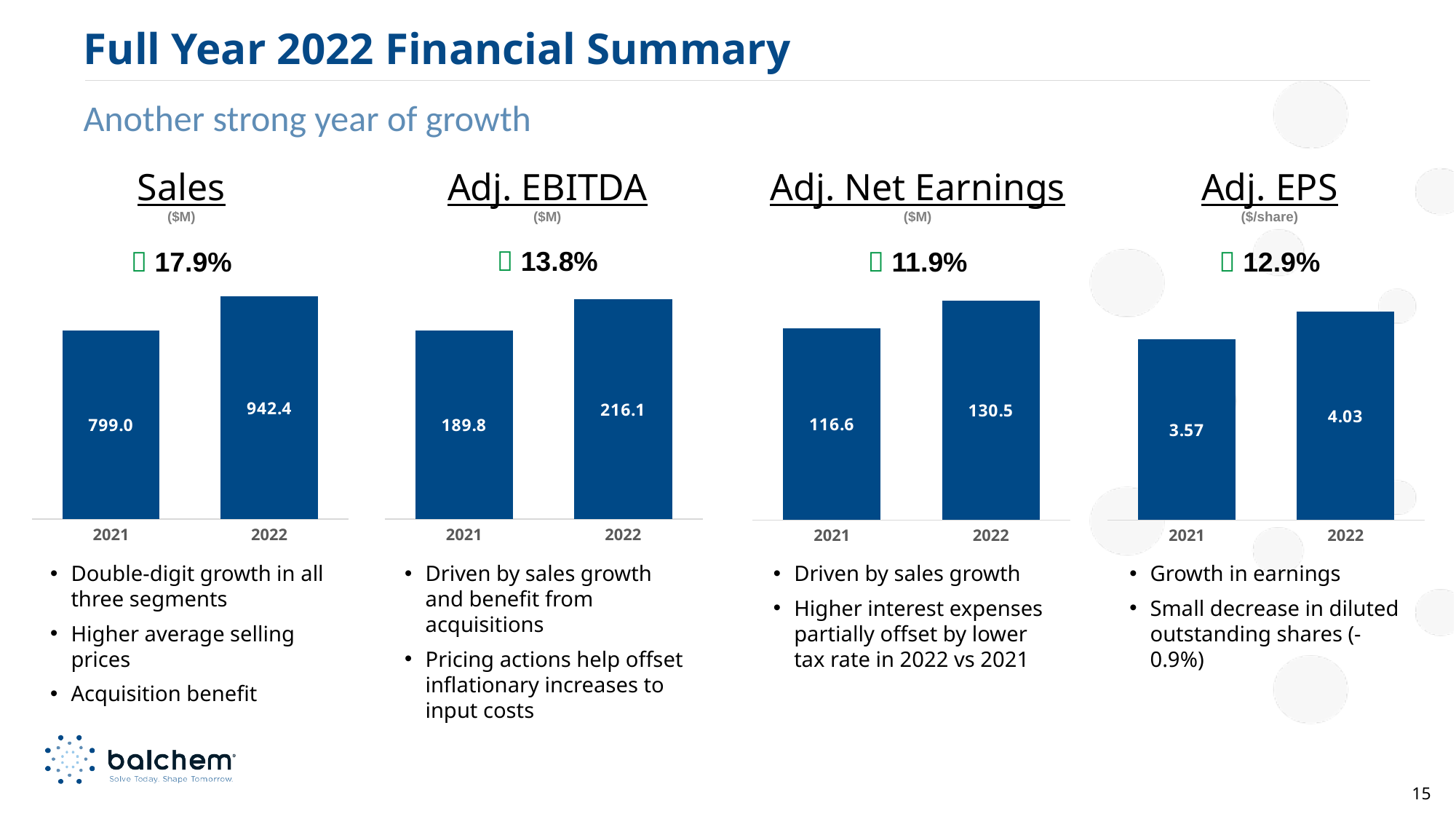
In the Adj. EBITDA chart, what is the difference between the 2022 and 2021 values? 26.3 What kind of chart is the Adj. Net Earnings chart? bar chart In the Adj. Net Earnings chart, what is the value for 2022? 130.5 In the Adj. EPS chart, which year has the lower value? 2021 In the Sales chart, what is the value for 2022? 942.4 In the Adj. Net Earnings chart, which year has the higher value? 2022 In the Adj. EBITDA chart, what is the value for 2021? 189.8 In the Adj. EPS chart, what is the value for 2021? 3.57 In the Sales chart, what is the difference between the 2022 and 2021 values? 143.4 How many bars are in the Sales chart? 2 In the Adj. EPS chart, is the value for 2022 larger or smaller than the value for 2021? larger What percentage growth is shown above the Adj. EBITDA chart? 13.8%